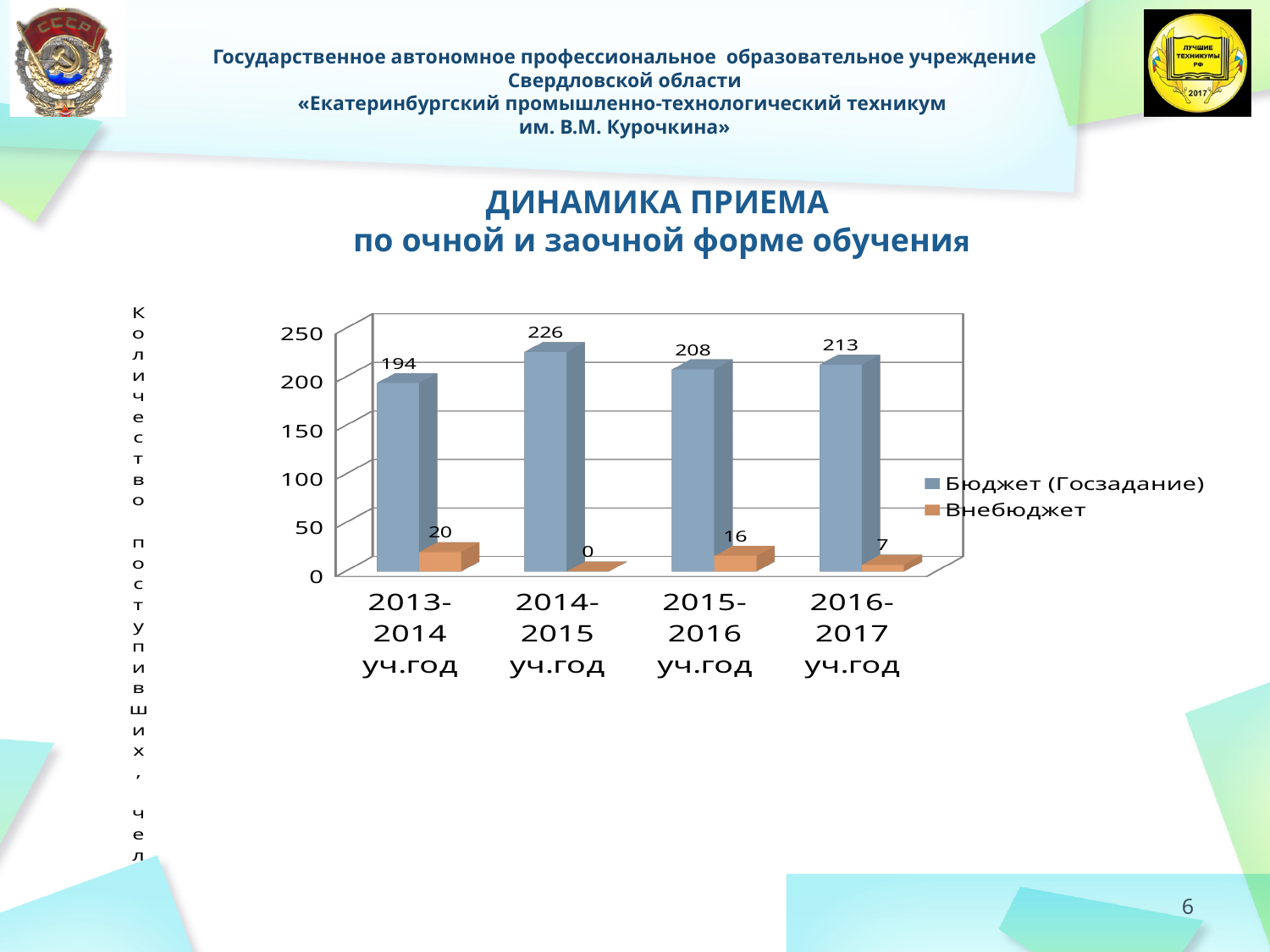
How many academic years are shown on the x axis? 4 Which academic year has the lowest value for Внебюджет? 2014-2015 уч.год What is the value for Бюджет (Госзадание) in 2014-2015 уч.год? 226 What is the difference between the Бюджет (Госзадание) values for 2014-2015 уч.год and 2013-2014 уч.год? 32 Which is larger: the Бюджет (Госзадание) value for 2015-2016 уч.год or for 2016-2017 уч.год? 2016-2017 уч.год What is the value for Внебюджет in 2013-2014 уч.год? 20 How many series does the legend list? 2 Is the value for Бюджет (Госзадание) in 2013-2014 уч.год greater or less than 200? less Which academic year has the highest value for Бюджет (Госзадание)? 2014-2015 уч.год What is the total of Бюджет (Госзадание) and Внебюджет for 2015-2016 уч.год? 224 What kind of chart is shown on the slide? bar chart What is the value for Внебюджет in 2016-2017 уч.год? 7